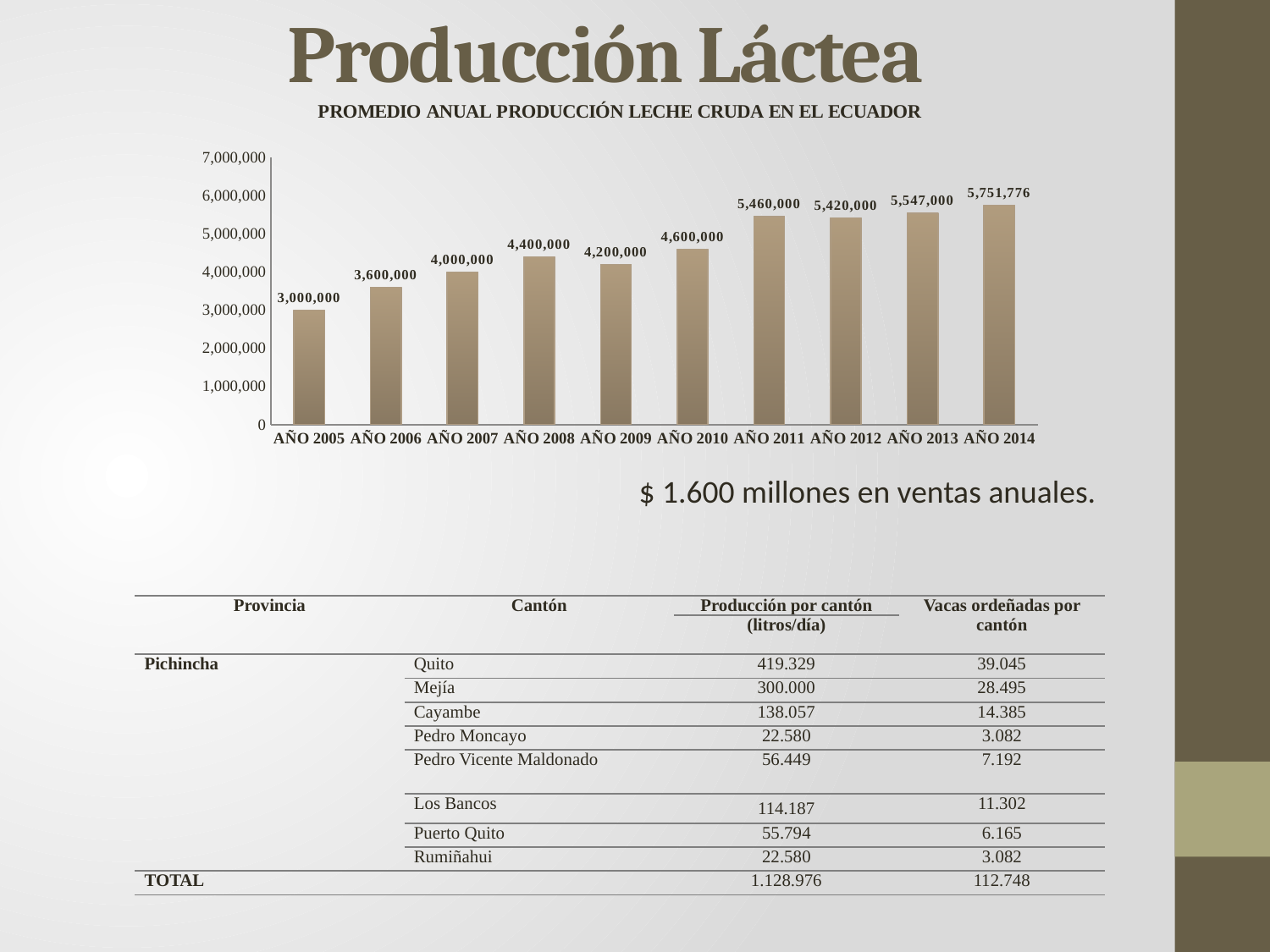
What is the difference between the values for AÑO 2011 and AÑO 2012? 40,000 What is the title of the chart? PROMEDIO ANUAL PRODUCCIÓN LECHE CRUDA EN EL ECUADOR Which year has the lowest value? AÑO 2005 Which year has the highest value? AÑO 2014 What is the value for AÑO 2009? 4,200,000 What is the difference between the values for AÑO 2014 and AÑO 2005? 2,751,776 How many years are shown on the x axis? 10 Is the value for AÑO 2010 greater or less than 5,000,000? less What kind of chart is shown on the slide? bar chart Which is larger, the value for AÑO 2008 or AÑO 2009? AÑO 2008 What is the value for AÑO 2011? 5,460,000 What is the value for AÑO 2014? 5,751,776